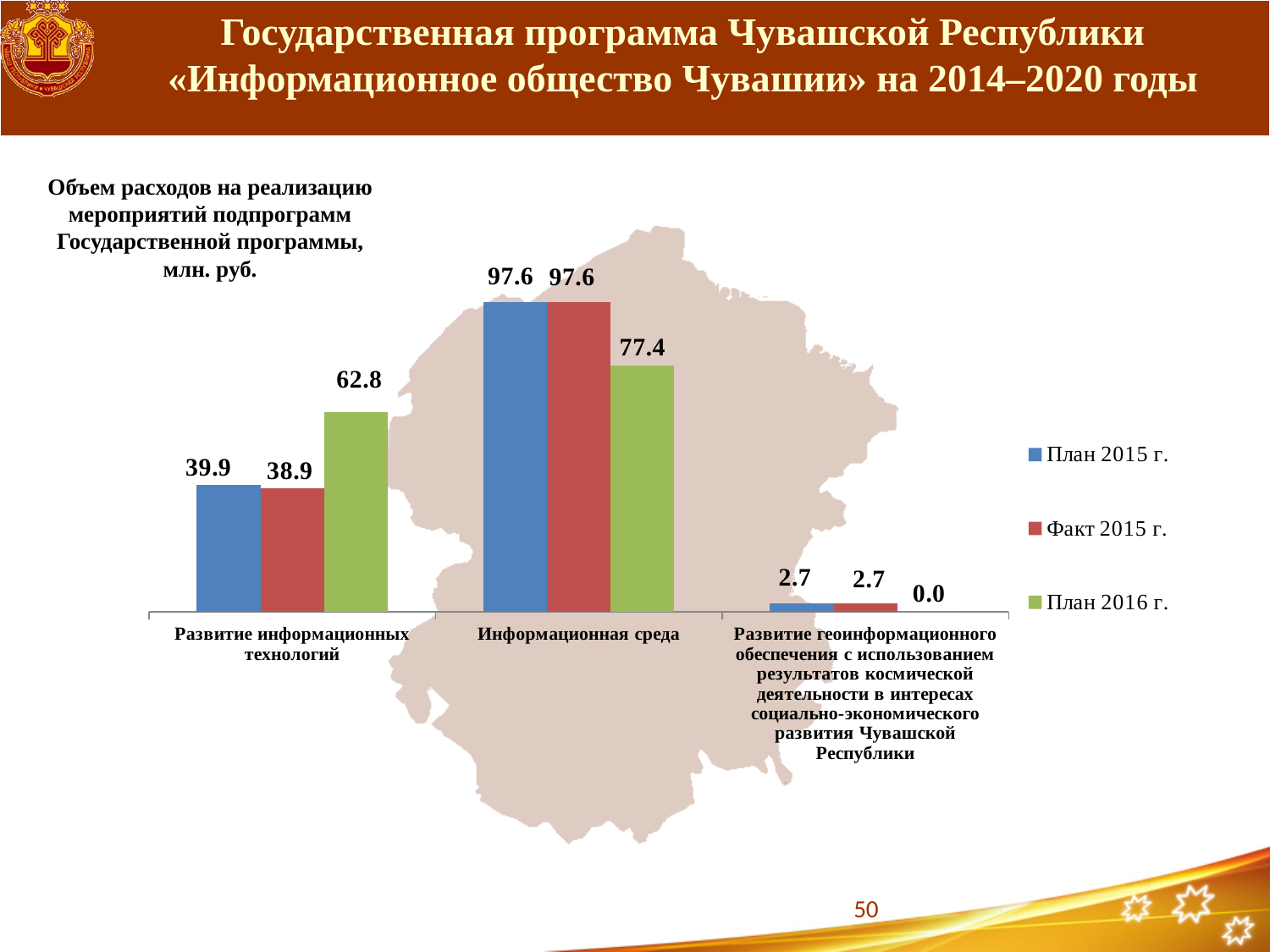
What is the difference between План 2015 г. and План 2016 г. for Информационная среда? 20.2 How many series does the chart legend list? 3 How many categories are shown on the x axis of the chart? 3 Which category has the lowest value for План 2016 г.? Развитие геоинформационного обеспечения с использованием результатов космической деятельности в интересах социально-экономического развития Чувашской Республики What is the value of Факт 2015 г. for Информационная среда? 97.6 What is the value of План 2016 г. for Развитие информационных технологий? 62.8 What is the value of Факт 2015 г. for Развитие информационных технологий? 38.9 For Развитие информационных технологий, which is larger: План 2015 г. or Факт 2015 г.? План 2015 г. What is the difference between План 2016 г. and План 2015 г. for Развитие информационных технологий? 22.9 What kind of chart is shown on the slide? Bar chart What is the value of План 2016 г. for Развитие геоинформационного обеспечения с использованием результатов космической деятельности в интересах социально-экономического развития Чувашской Республики? 0.0 Which category has the highest value for План 2015 г.? Информационная среда